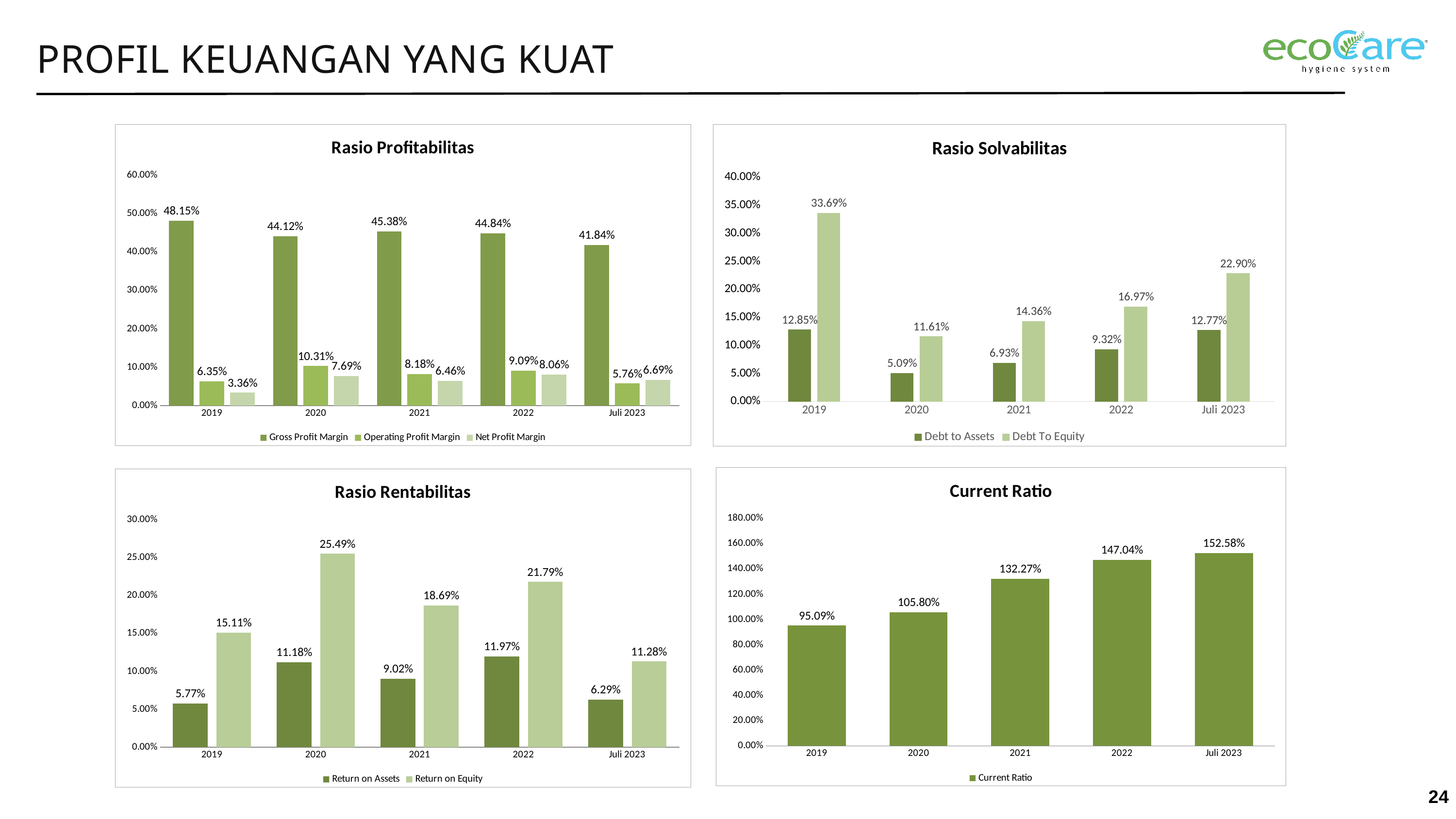
In the Rasio Profitabilitas chart, which year has the lowest Net Profit Margin? 2019 In the Current Ratio chart, what is the value for 2021? 132.27% In the Rasio Solvabilitas chart, what is the difference between Debt To Equity and Debt to Assets in 2022? 7.65% What kind of chart is the Current Ratio chart? bar chart In the Rasio Solvabilitas chart, which year has the highest Debt To Equity value? 2019 In the Rasio Rentabilitas chart, which is larger in 2021: Return on Assets or Return on Equity? Return on Equity In the Current Ratio chart, do the values rise or fall from 2019 to Juli 2023? rise In the Rasio Profitabilitas chart, what is the Gross Profit Margin for 2019? 48.15% In the Rasio Profitabilitas chart, how many series does the legend list? 3 In the Current Ratio chart, how many periods are shown on the x axis? 5 In the Rasio Rentabilitas chart, what is the Return on Equity for 2020? 25.49% In the Rasio Solvabilitas chart, what is the Debt To Equity value for Juli 2023? 22.90%